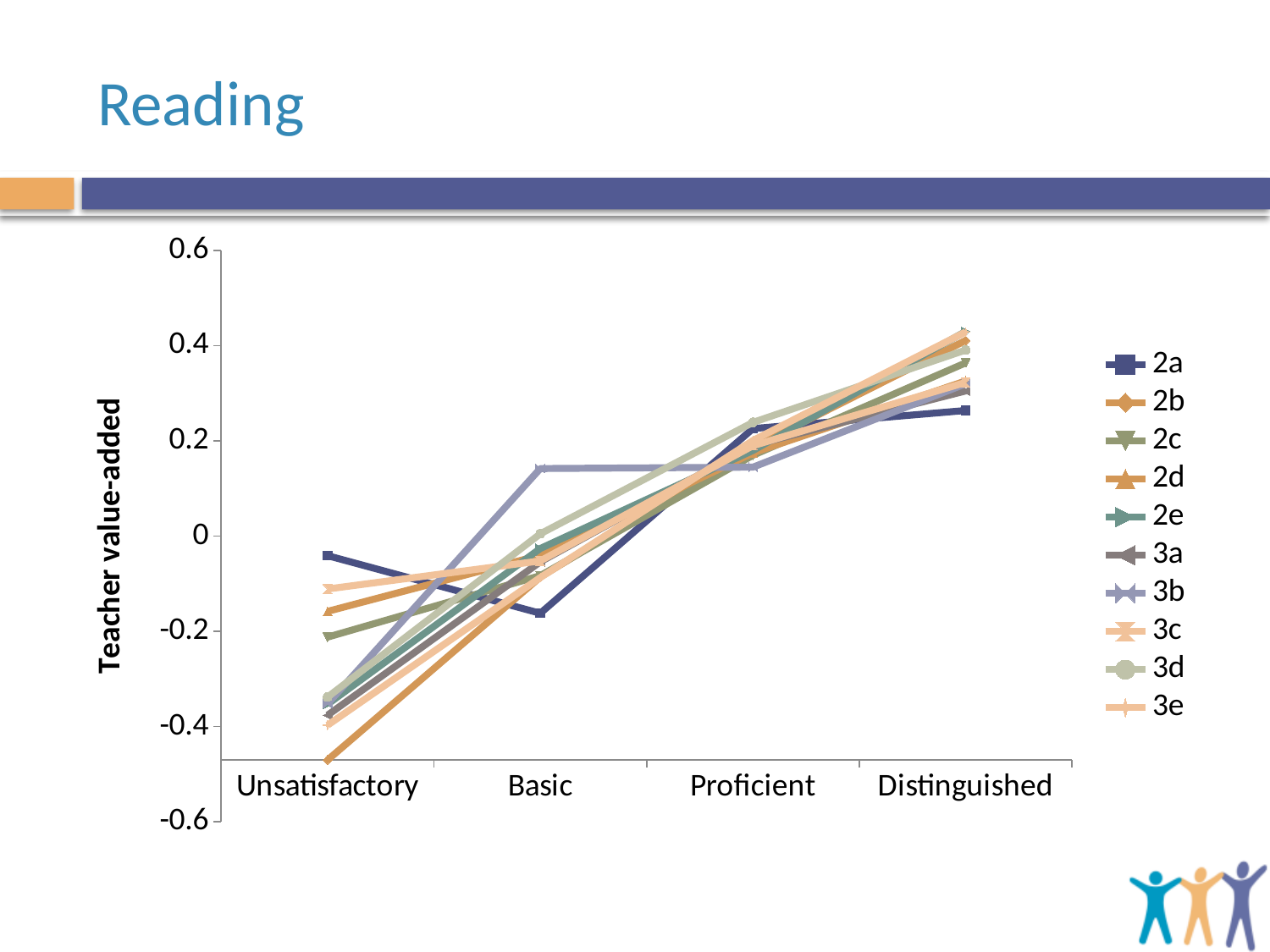
Which series has the highest value at Unsatisfactory? 2a Which series has the highest value at Basic? 3b Is the value for series 2a at Basic greater or less than 0? less How many series does the legend list? 10 What is the title of the vertical axis? Teacher value-added What kind of chart is shown on the slide? line chart Is the value for series 2a at Distinguished greater or less than 0.2? greater Is the value for series 2b at Unsatisfactory greater or less than -0.4? less How many categories are shown on the x axis? 4 Do the values for series 2b rise or fall from Unsatisfactory to Distinguished? rise Which series has the lowest value at Unsatisfactory? 2b